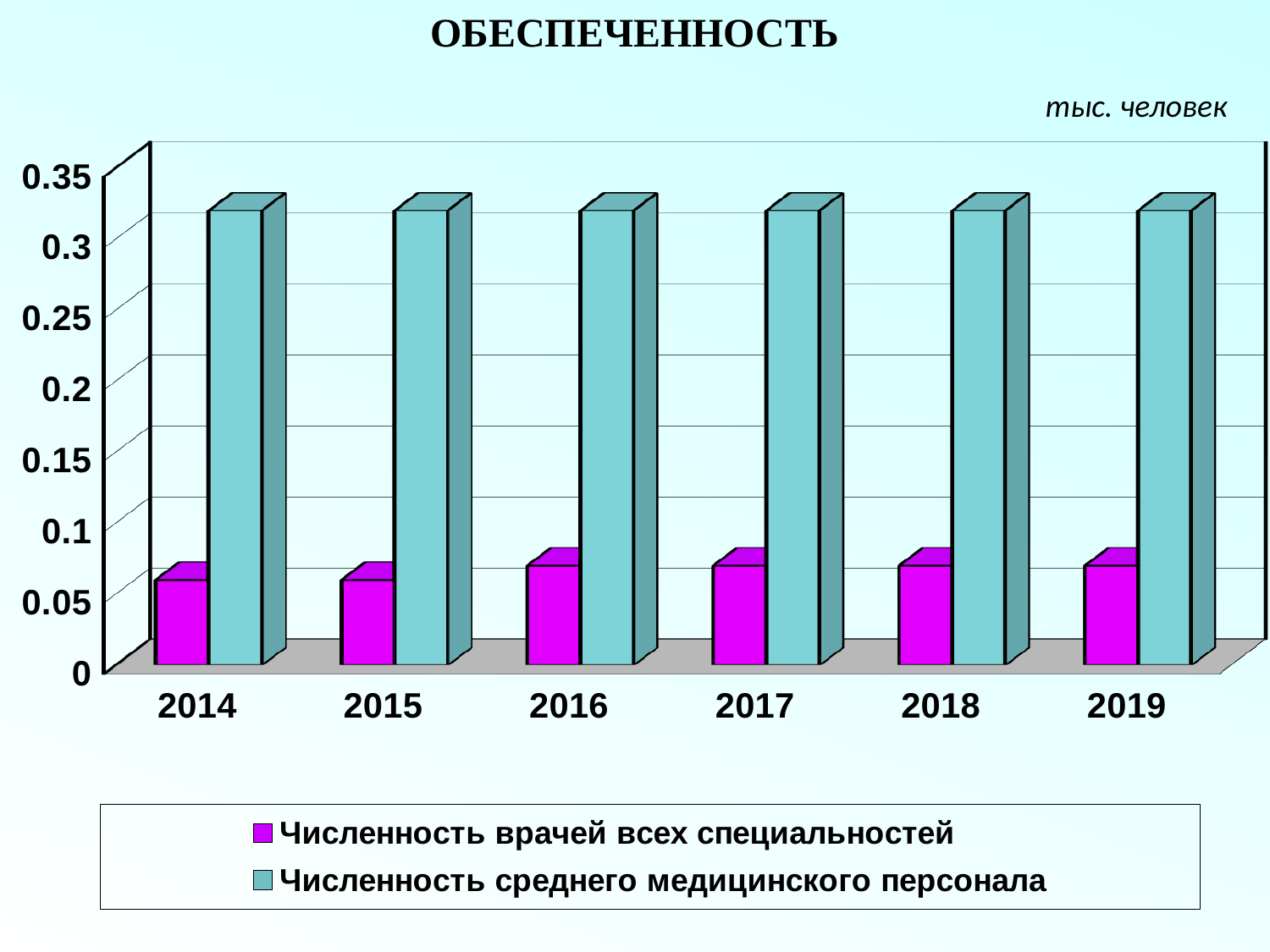
What is the title of the chart? ОБЕСПЕЧЕННОСТЬ How many years are shown on the x axis of the chart? 6 Is the value for Численность среднего медицинского персонала in 2014 greater or less than 0.3? greater Is the value for Численность среднего медицинского персонала in 2019 greater or less than 0.35? less Is the value for Численность врачей всех специальностей in 2016 greater or less than 0.1? less What unit is indicated above the chart? тыс. человек Which series is shown in magenta in the chart? Численность врачей всех специальностей What kind of chart is shown on the slide? Bar chart How many series does the legend list? 2 In 2017, which series has the larger value: Численность врачей всех специальностей or Численность среднего медицинского персонала? Численность среднего медицинского персонала